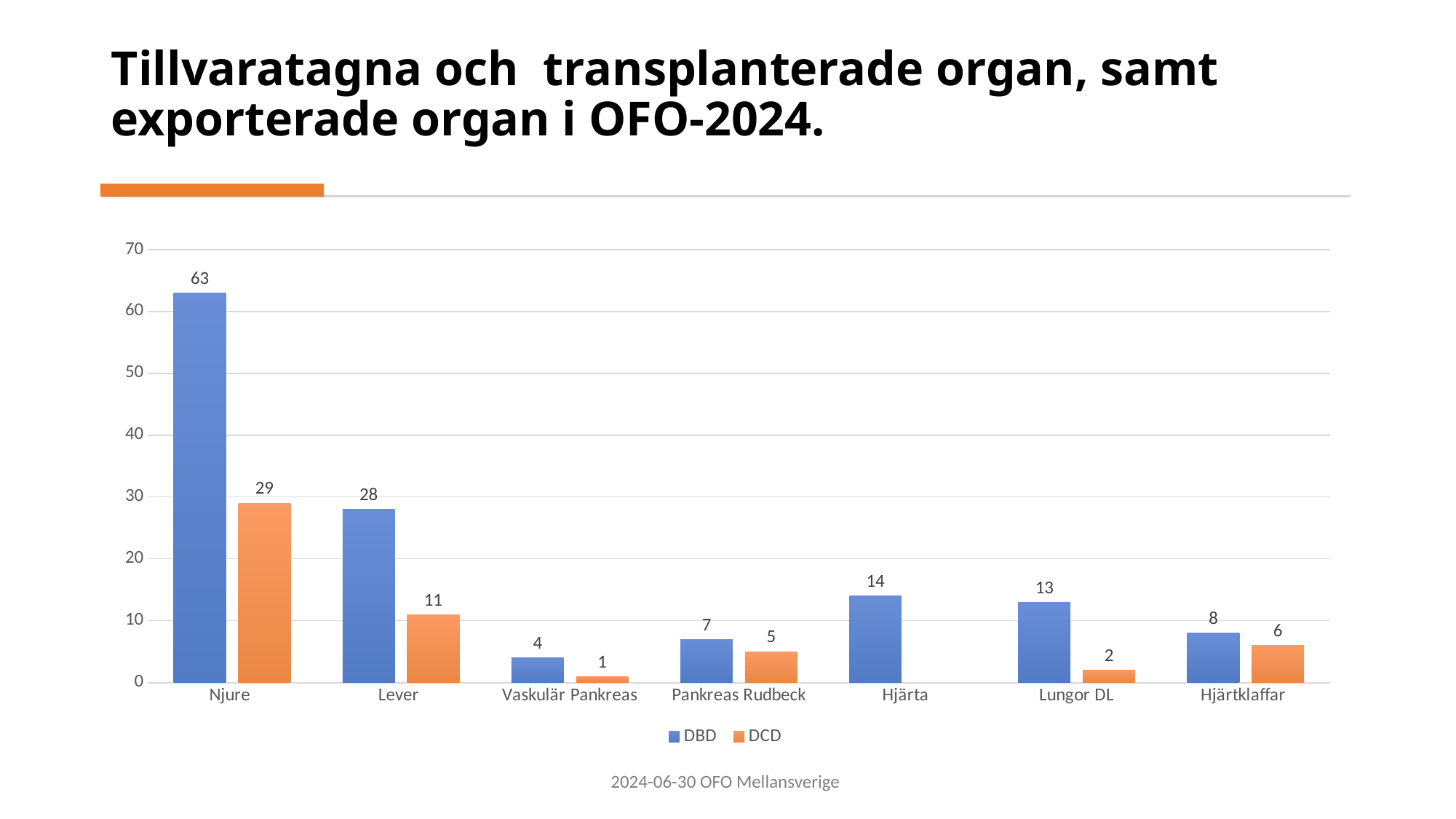
Which is larger, the DBD value for Hjärta or the DBD value for Lungor DL? DBD value for Hjärta How many categories are shown on the x axis? 7 What is the difference between the DBD and DCD values for Njure? 34 What is the DCD value for Hjärtklaffar? 6 What is the DBD value for Lungor DL? 13 Which category has the highest DBD value? Njure What kind of chart is shown on the slide? Bar chart Which colour represents the DCD series in the legend? Orange Which category has the lowest DCD value among those with a DCD bar? Vaskulär Pankreas What is the DCD value for Lever? 11 What is the DBD value for Njure? 63 How many series does the legend list? 2